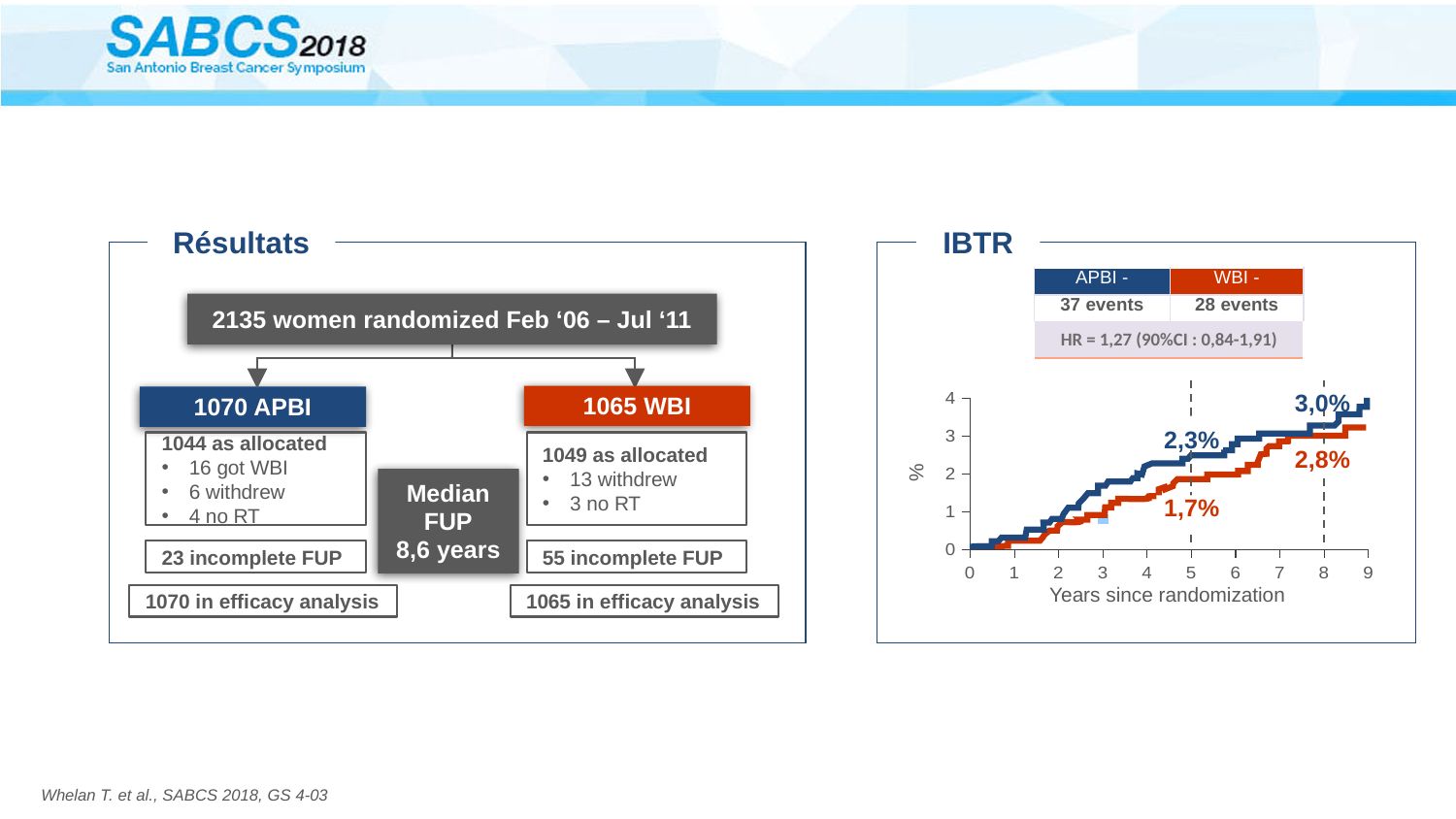
What is the title of the chart on the right side of the slide? IBTR In the IBTR chart, is the APBI value at 3 years greater or less than 2? less In the IBTR chart, what is the labelled value for WBI at 8 years since randomization? 2,8% What kind of chart is the IBTR chart? line chart What is the x-axis title of the IBTR chart? Years since randomization In the IBTR chart, what is the labelled value for APBI at 5 years since randomization? 2,3% In the IBTR chart, which arm has the higher value at 5 years, APBI or WBI? APBI In the IBTR chart, what is the labelled value for WBI at 5 years since randomization? 1,7% In the IBTR chart, what is the difference between the APBI and WBI values at 5 years? 0,6% In the IBTR chart, what is the labelled value for APBI at 8 years since randomization? 3,0% How many series are plotted in the IBTR chart? 2 In the IBTR chart, do the curves rise or fall as years since randomization increase? rise